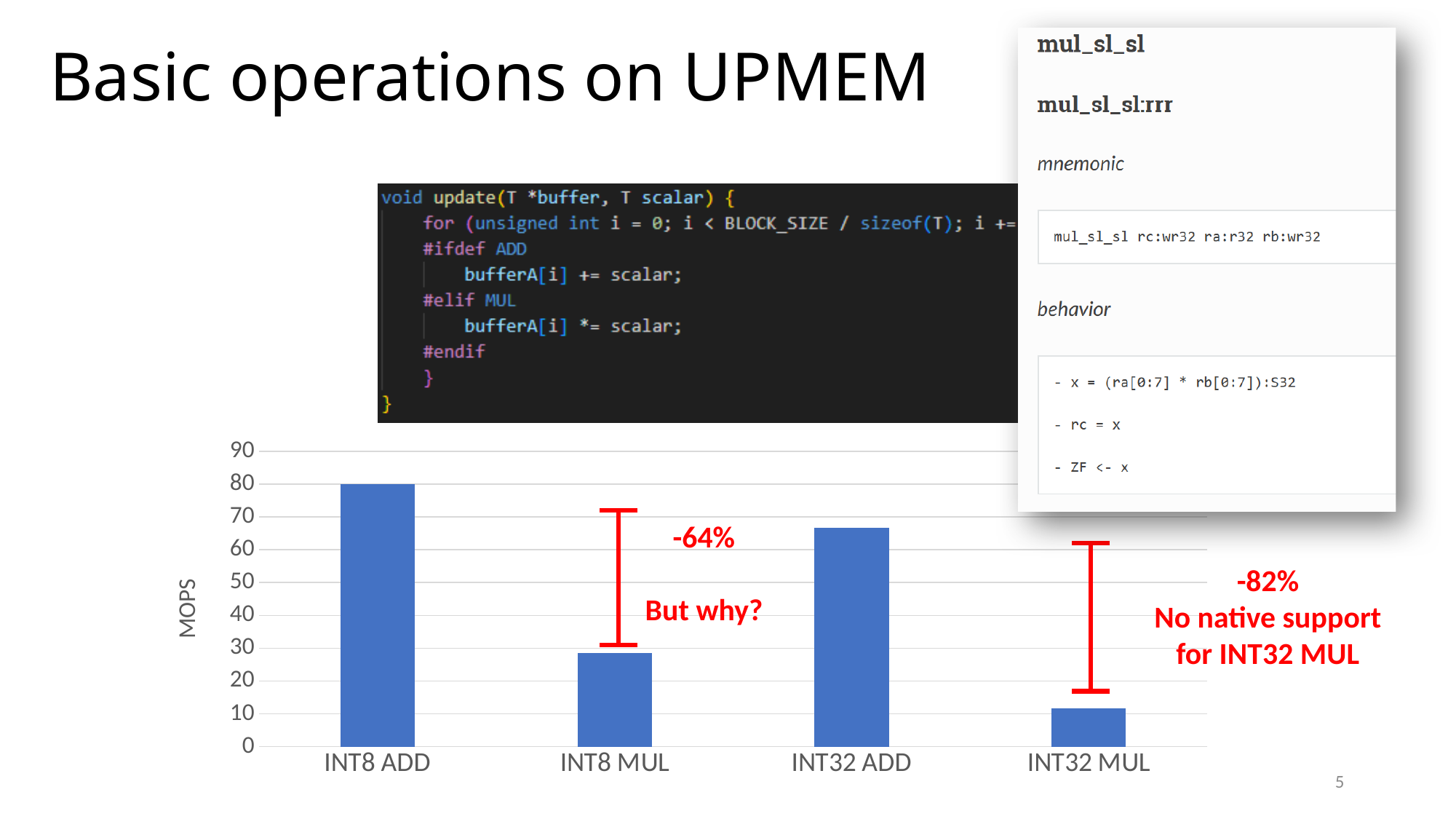
Is the value for INT8 MUL greater or less than 40? less Which is larger, the value for INT8 ADD or the value for INT32 ADD? INT8 ADD Is the value for INT32 MUL greater or less than 20? less Which category has the highest value in the chart? INT8 ADD How many categories are shown on the x axis of the chart? 4 Is the value for INT8 ADD greater or less than 70? greater What percentage drop is annotated between INT32 ADD and INT32 MUL in the chart? -82% What is the label on the y axis of the chart? MOPS Which category has the lowest value in the chart? INT32 MUL Which is larger, the value for INT8 MUL or the value for INT32 ADD? INT32 ADD What kind of chart is shown on the slide? bar chart